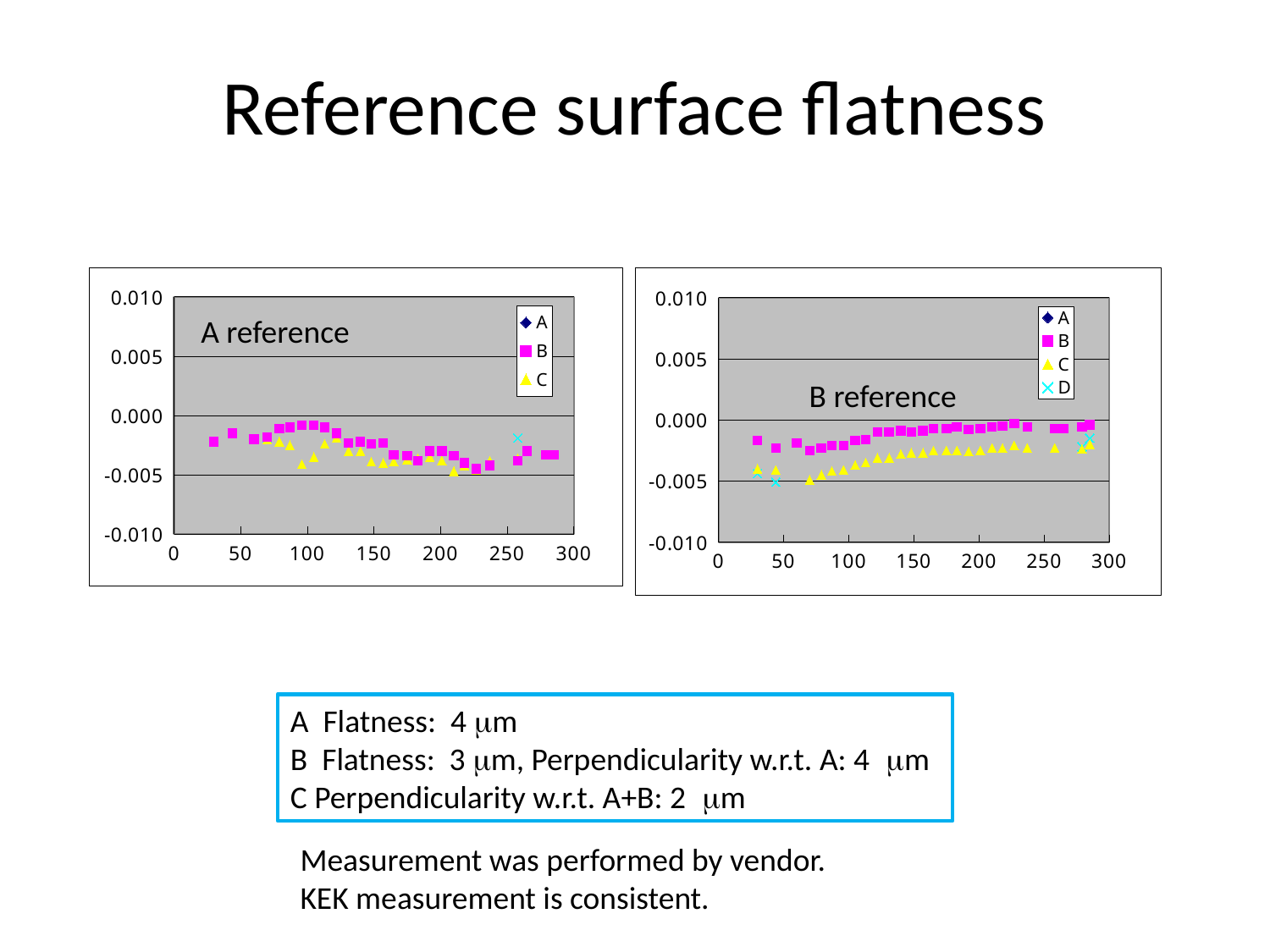
In the 'A reference' chart on the left, is the value of series B at x = 100 greater or less than 0.000? less In the 'B reference' chart on the right, is the value of series B at x = 200 greater or less than -0.005? greater In the 'B reference' chart on the right, at x = 150, which series has the larger value, B or C? B What kind of chart is the 'A reference' chart on the left? scatter chart What is the maximum value shown on the y axis of the 'A reference' chart on the left? 0.010 In the 'B reference' chart on the right, do the values of series B rise or fall as x increases from 50 to 250? rise In the 'A reference' chart on the left, is the value of series C at x = 100 greater or less than 0.000? less How many series does the legend of the 'A reference' chart on the left list? 3 How many series does the legend of the 'B reference' chart on the right list? 4 In the 'B reference' chart on the right, which series is listed last in the legend? D In the 'B reference' chart on the right, do the values of series C rise or fall as x increases from 50 to 250? rise